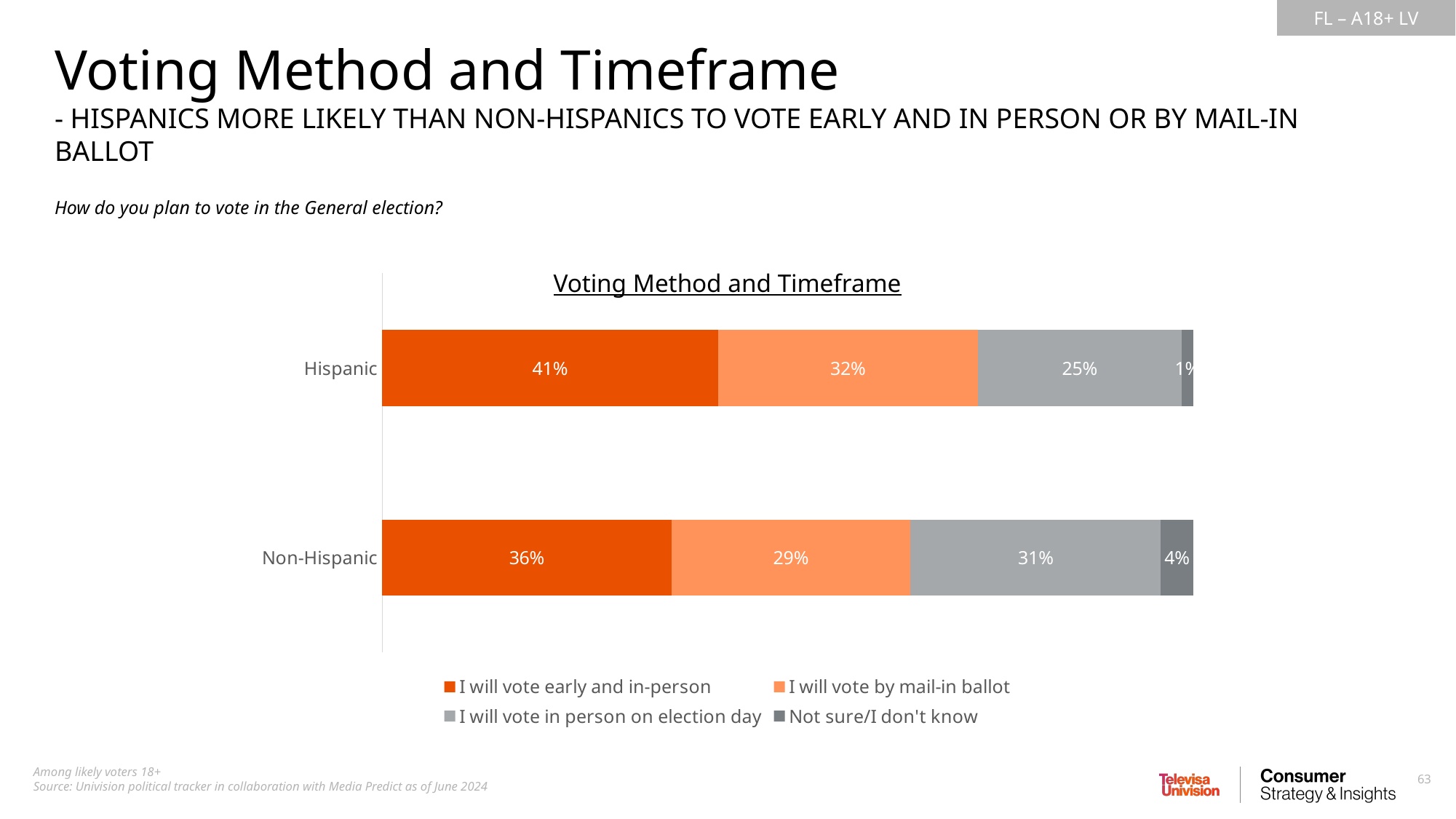
What is the difference in percentage points between Hispanic and Non-Hispanic voters who will vote by mail-in ballot? 3 percentage points Which group has the higher share saying they will vote in person on election day, Hispanic or Non-Hispanic? Non-Hispanic Which group has the higher share saying they will vote early and in-person, Hispanic or Non-Hispanic? Hispanic How many series does the legend list? 4 What is the difference in percentage points between Non-Hispanic and Hispanic voters who are not sure/don't know? 3 percentage points What type of chart is shown on the slide? Stacked bar chart Which voting method has the largest share among Hispanic likely voters? I will vote early and in-person What percentage of Non-Hispanic likely voters say they will vote by mail-in ballot? 29% Which response has the smallest share among Non-Hispanic likely voters? Not sure/I don't know What percentage of Non-Hispanic likely voters say they will vote in person on election day? 31% What percentage of Hispanic likely voters say they will vote early and in-person? 41% What percentage of Hispanic likely voters are not sure or don't know how they will vote? 1%